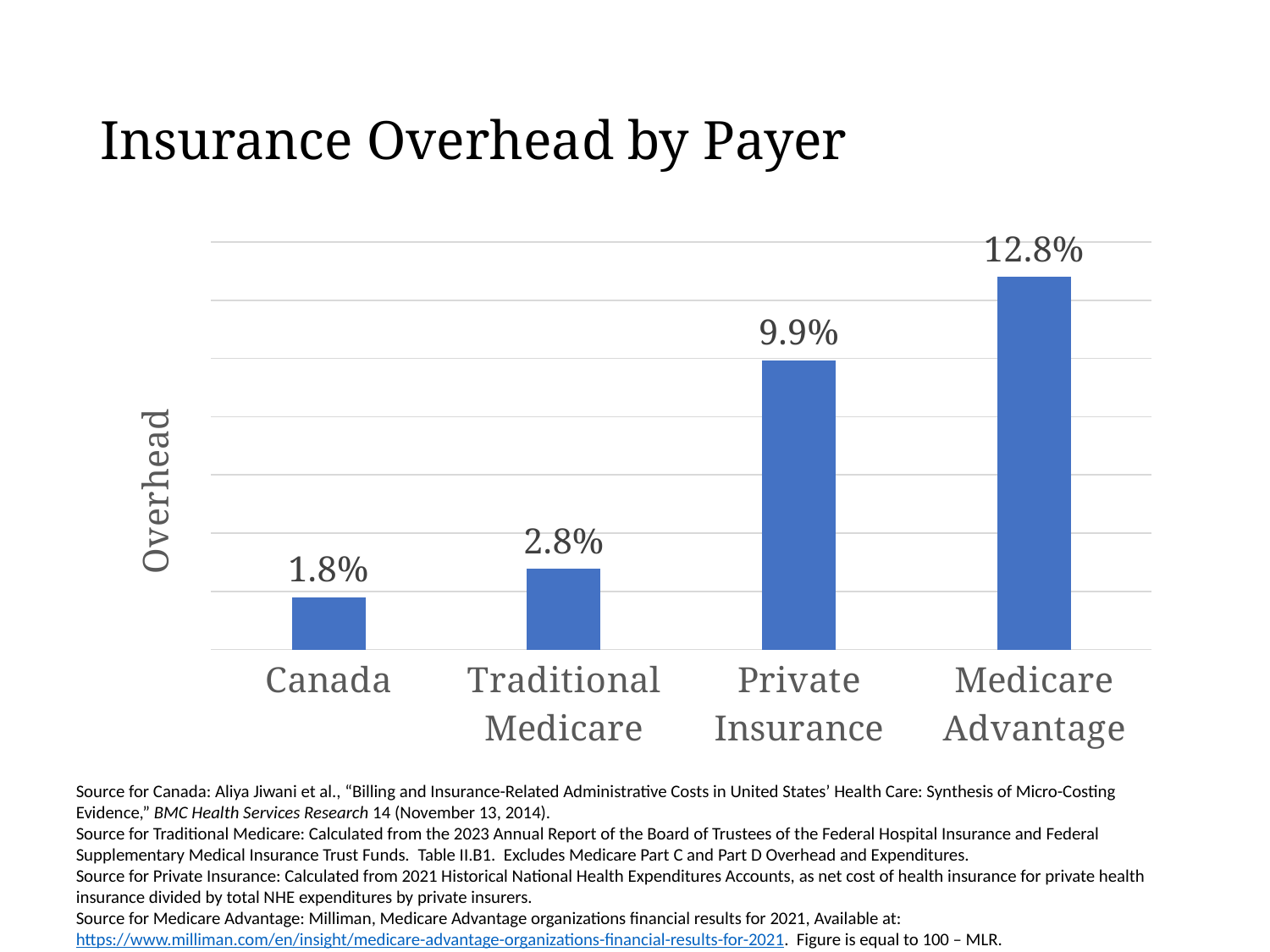
What is the overhead value for Traditional Medicare? 2.8% Which payer has the highest overhead? Medicare Advantage What type of chart is shown on the slide? Bar chart Which has a higher overhead, Private Insurance or Traditional Medicare? Private Insurance What is the overhead value for Private Insurance? 9.9% What is the overhead value for Canada? 1.8% What is the difference in overhead between Medicare Advantage and Private Insurance? 2.9% What is the difference in overhead between Traditional Medicare and Canada? 1.0% Which payer has the lowest overhead? Canada What is the overhead value for Medicare Advantage? 12.8% How many payers are shown in the chart? 4 What is the title of the chart? Insurance Overhead by Payer